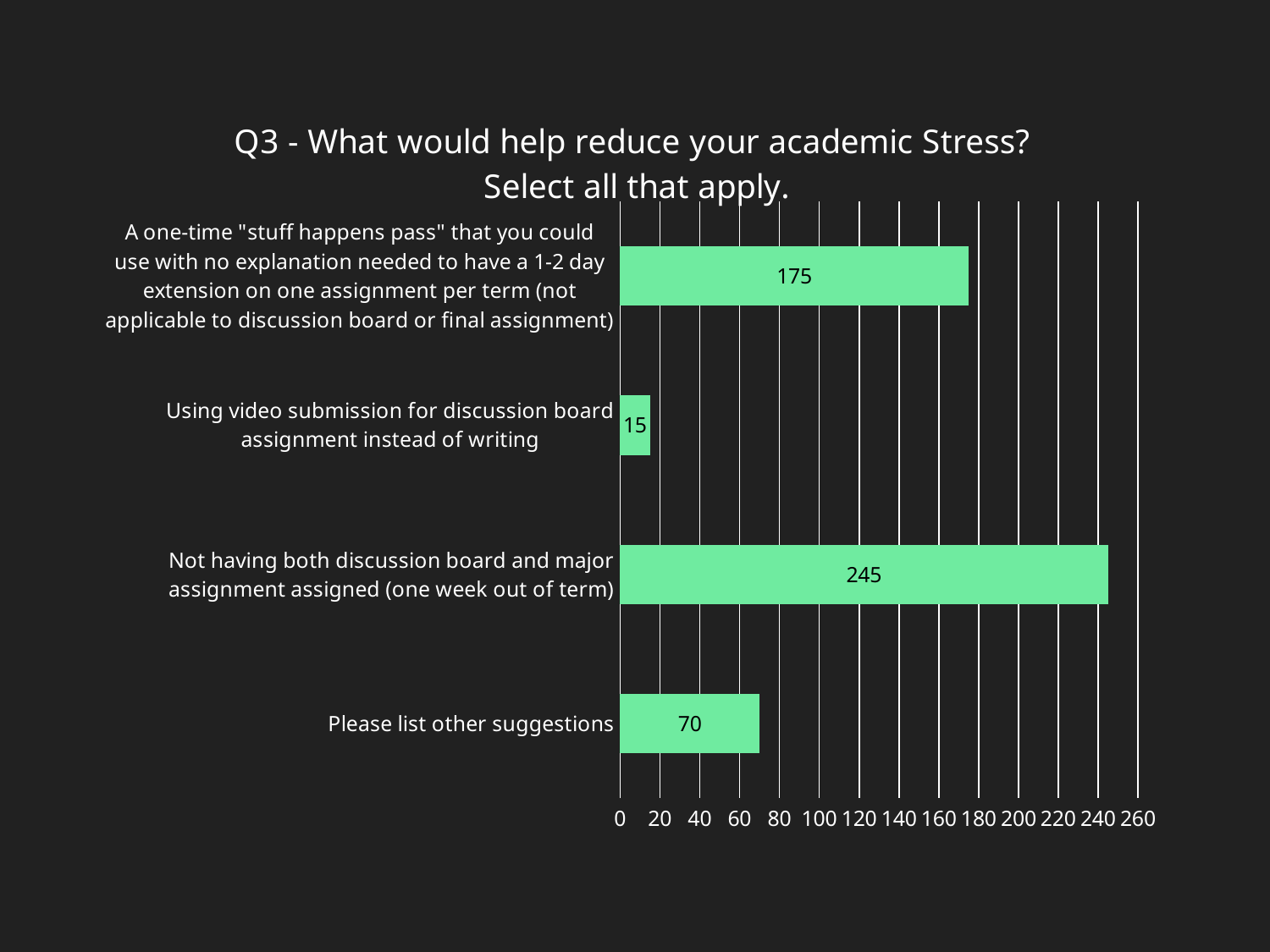
How many categories are shown in the chart? 4 Which category has the highest value? Not having both discussion board and major assignment assigned (one week out of term) What is the value for "Not having both discussion board and major assignment assigned (one week out of term)"? 245 What kind of chart is shown on the slide? bar chart What is the title of the chart? Q3 - What would help reduce your academic Stress? Select all that apply. Is the value for the one-time "stuff happens pass" option greater or less than 160? greater What is the difference between the values for "Not having both discussion board and major assignment assigned" and the one-time "stuff happens pass" option? 70 Which is larger: the value for "Please list other suggestions" or the value for "Using video submission for discussion board assignment instead of writing"? Please list other suggestions What is the value for "Using video submission for discussion board assignment instead of writing"? 15 What is the value for the one-time "stuff happens pass" option? 175 Which category has the lowest value? Using video submission for discussion board assignment instead of writing What is the value for "Please list other suggestions"? 70